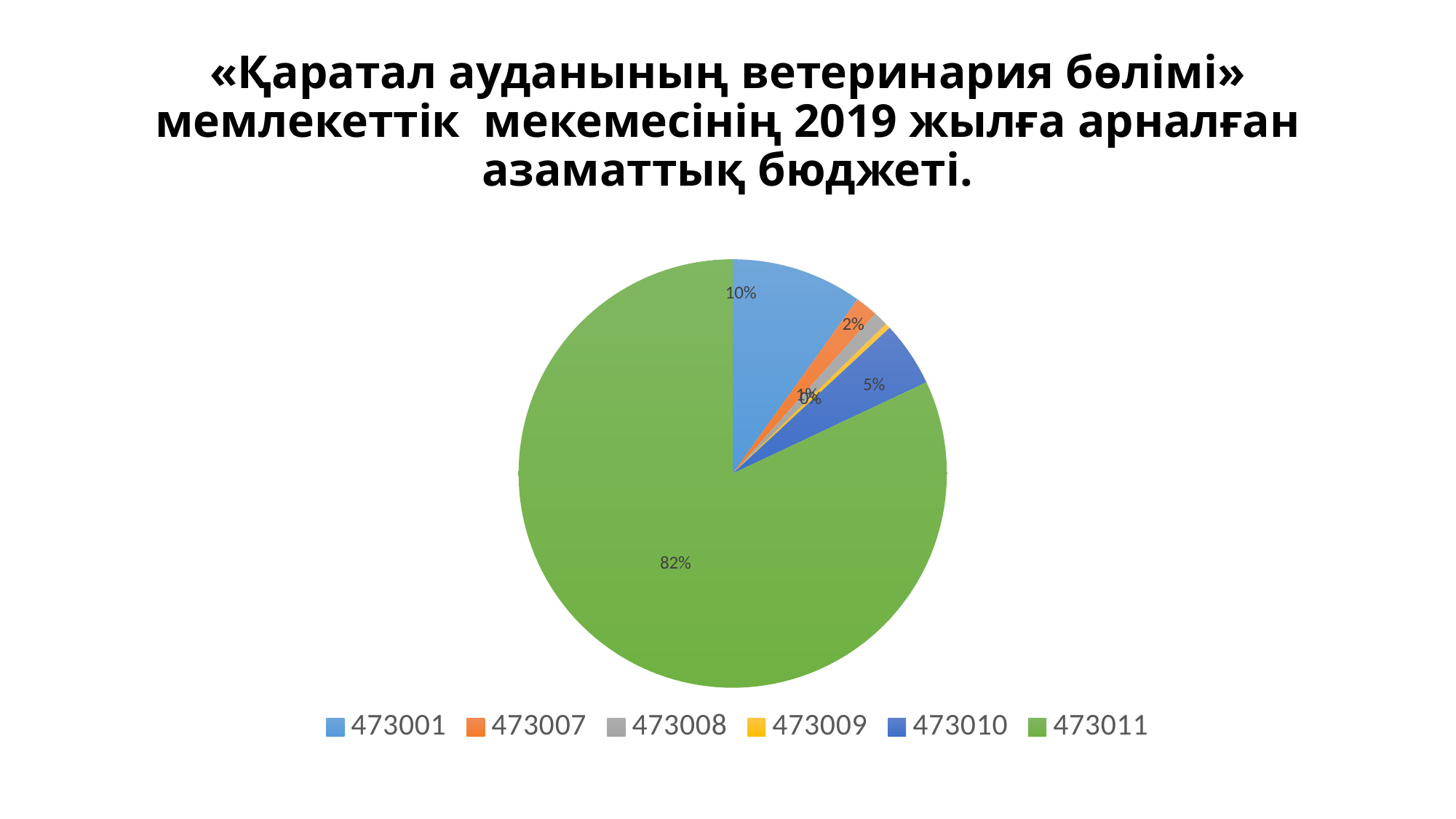
How many categories does the legend of the pie chart list? 6 Which is larger, the slice for 473001 or the slice for 473010? 473001 Which category has the smallest slice of the pie? 473009 What share of the pie does category 473010 have? 5% Which category has the largest slice of the pie? 473011 What share of the pie does category 473007 have? 2% What kind of chart is shown on the slide? pie chart What is the difference in percentage points between the slices for 473011 and 473001? 72 Which year is named in the chart title? 2019 Which colour is used for category 473011 in the pie chart? green What share of the pie does category 473011 have? 82%